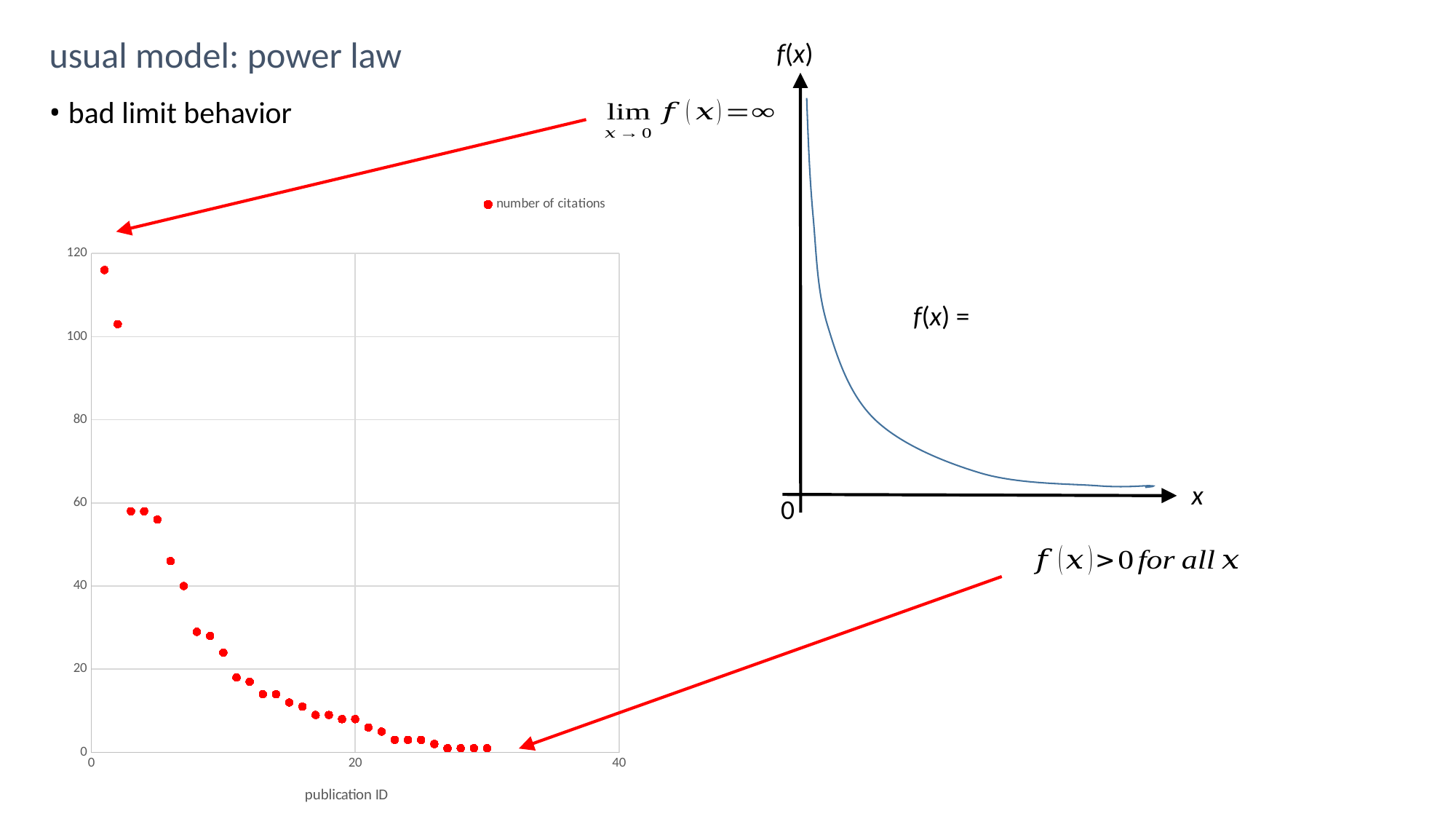
In the left chart, do the values rise or fall as publication ID increases? fall In the left chart, is the value for publication ID 7 greater or less than 60? less What is the x-axis title of the left chart? publication ID What is the highest tick value shown on the y-axis of the left chart? 120 How many data points are plotted in the left chart? 30 In the left chart, is the value for publication ID 30 greater or less than 20? less What is the legend entry of the left chart? number of citations In the left chart, which publication ID has the highest number of citations? 1 In the left chart, is the value for the first point (publication ID 1) greater or less than 100? greater What kind of chart is the chart on the left of the slide? scatter chart How many series does the legend of the left chart list? 1 In the left chart, which has more citations: publication ID 1 or publication ID 10? publication ID 1